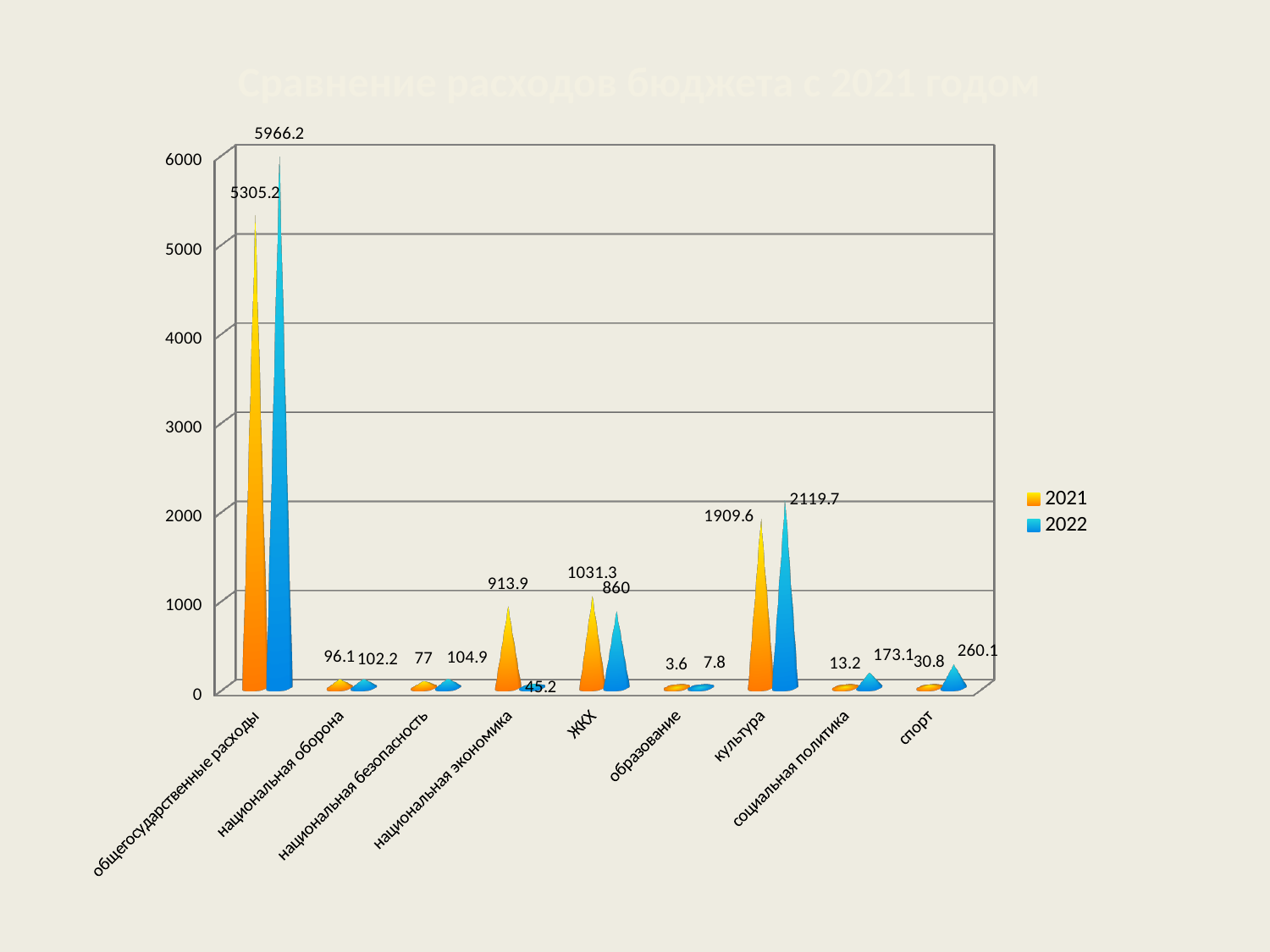
What kind of chart is shown on the slide? bar chart Is the 2022 value for культура greater or less than 2000? greater What is the 2021 value for культура? 1909.6 Which category has the lowest 2021 value? образование What is the 2021 value for ЖКХ? 1031.3 What is the 2022 value for общегосударственные расходы? 5966.2 How many categories are shown on the x axis? 9 For ЖКХ, which is larger: the 2021 value or the 2022 value? 2021 What is the 2022 value for национальная экономика? 45.2 What is the difference between the 2022 and 2021 values for спорт? 229.3 Which category has the highest 2022 value? общегосударственные расходы How many series does the legend list? 2